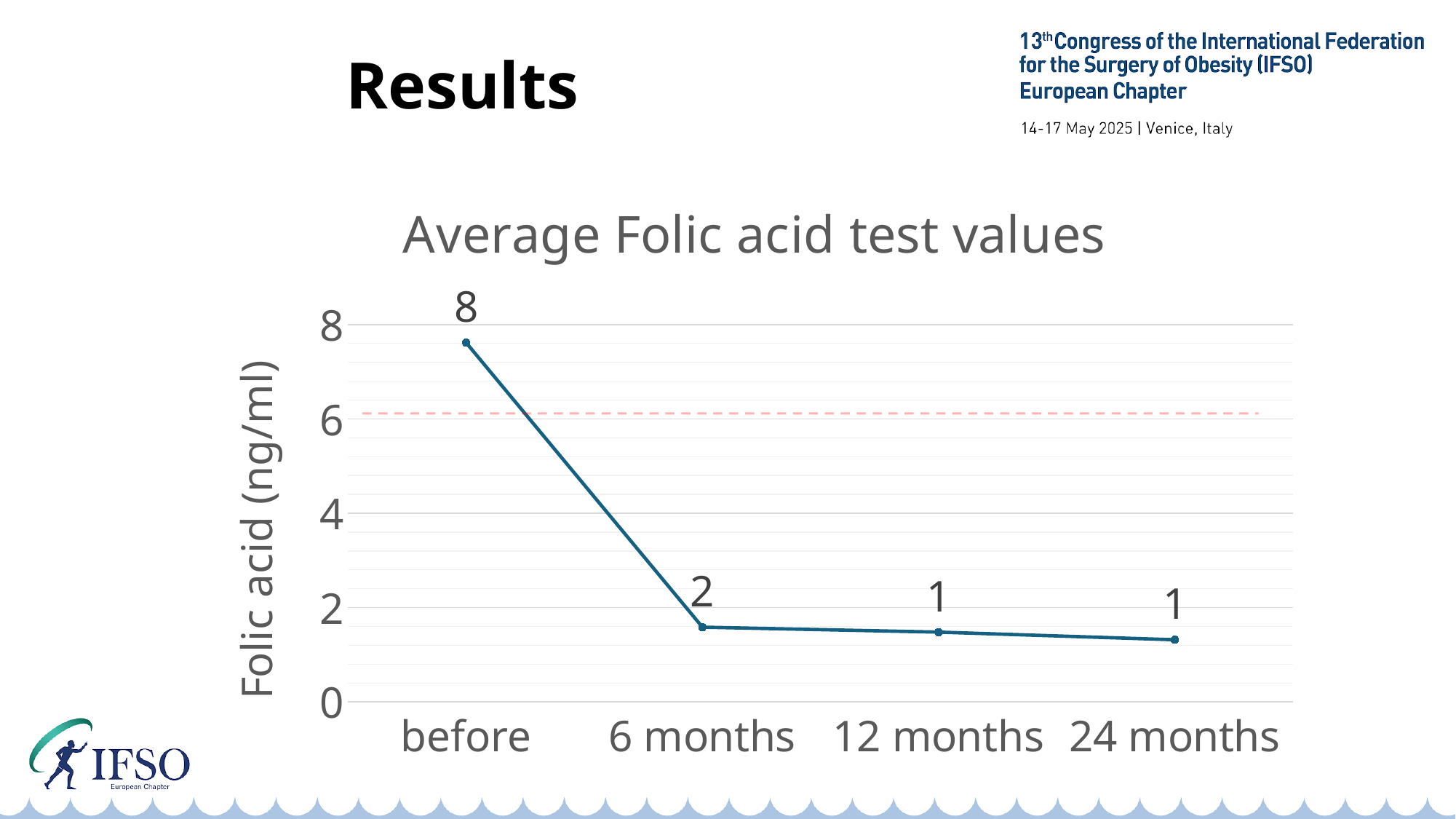
What is the average folic acid value labelled for 'before'? 8 Is the value for 'before' greater or less than 6? greater Do the average folic acid values rise or fall from 'before' to 24 months? fall What is the difference between the labelled values for 'before' and 6 months? 6 How many time points are plotted on the chart? 4 What is the average folic acid value labelled at 6 months? 2 What is the average folic acid value labelled at 12 months? 1 Which time point has the highest average folic acid value? before What kind of chart is shown on the slide? line chart Is the value at 6 months greater or less than 4? less What is the average folic acid value labelled at 24 months? 1 Which is larger, the value for 'before' or the value at 6 months? before